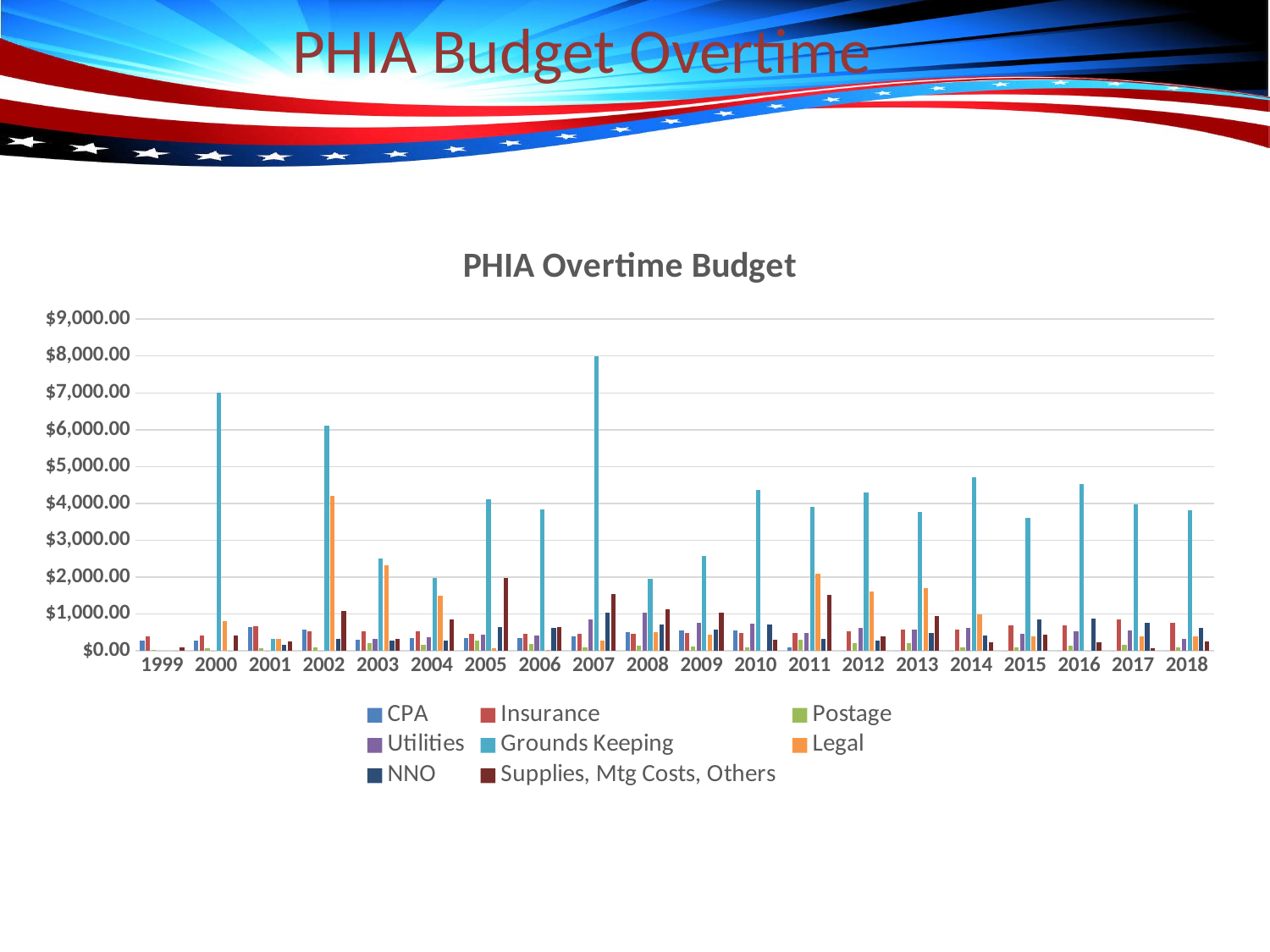
Is the Grounds Keeping value for 2007 greater or less than $7,000.00? greater Which is larger, the Grounds Keeping value for 2002 or for 2003? 2002 Is the Grounds Keeping value for 2002 greater or less than $5,000.00? greater What is the title of the chart? PHIA Overtime Budget Is the Legal value for 2002 greater or less than $3,000.00? greater Which series has the highest value in 2007? Grounds Keeping How many years are shown along the x axis? 20 How many series does the legend list? 8 Which is larger, the Legal value for 2002 or for 2011? 2002 What kind of chart is shown on the slide? Bar chart In which year is the Grounds Keeping value highest? 2007